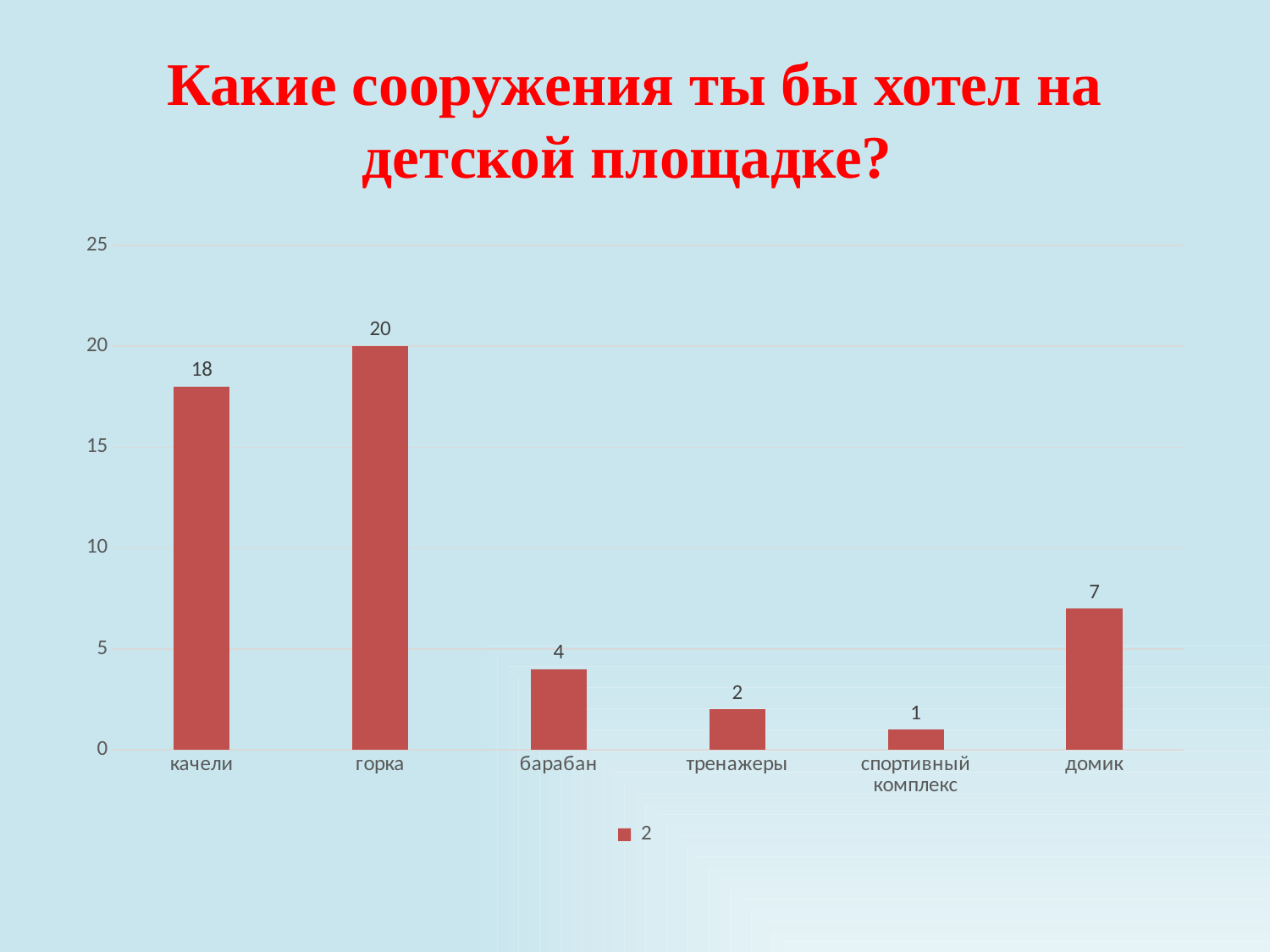
What is the difference between the values for горка and качели? 2 Which category has the lowest value? спортивный комплекс Which is larger, the value for домик or the value for барабан? домик What is the legend entry shown below the chart? 2 What kind of chart is shown on the slide? bar chart What is the value for домик? 7 Which category has the highest value? горка What is the value for барабан? 4 Is the value for тренажеры greater or less than 5? less How many categories are shown on the x axis? 6 What is the value for горка? 20 What is the value for качели? 18